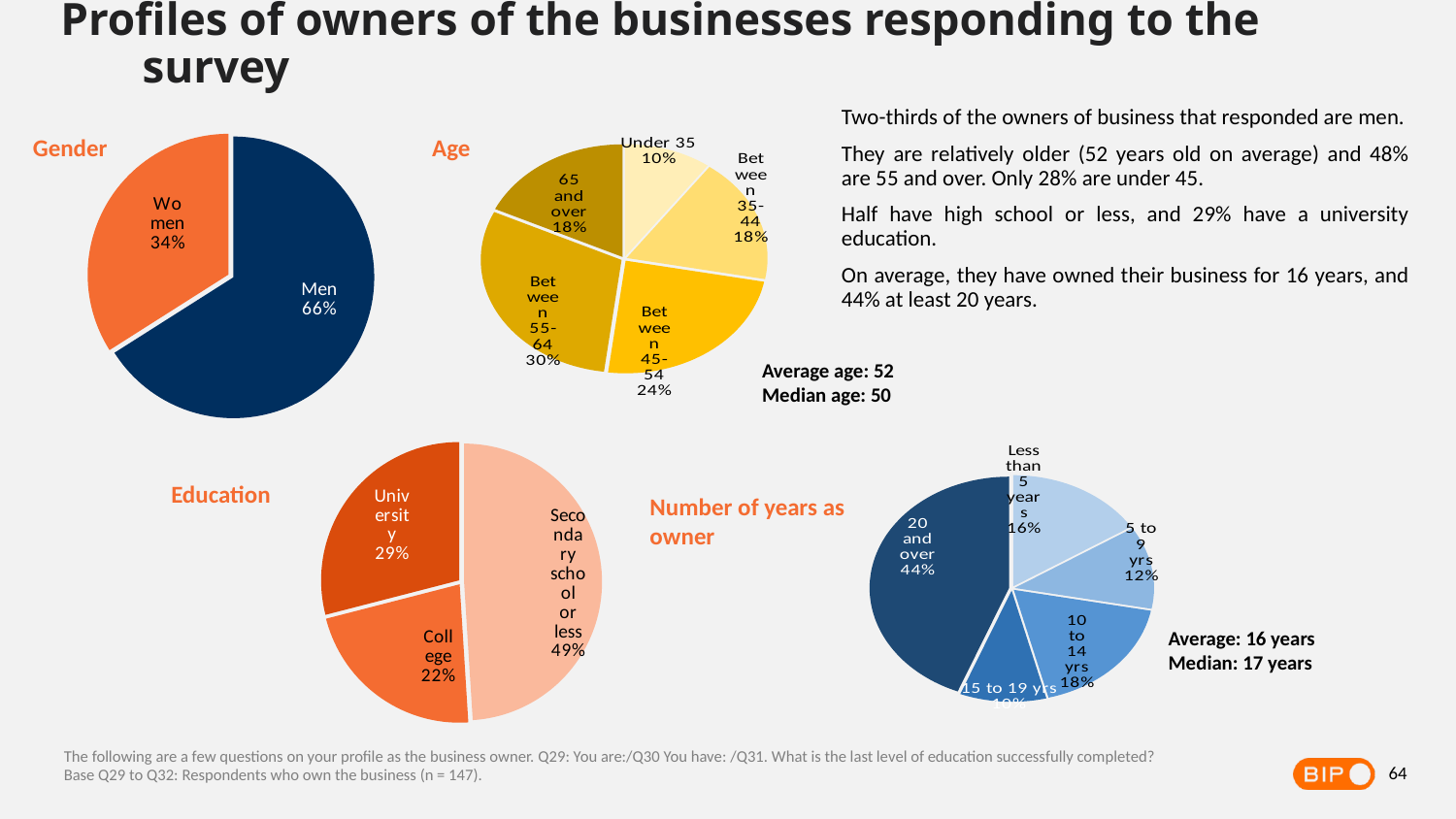
In the Number of years as owner pie chart, what share of owners have owned their business for 20 years and over? 44% In the Gender pie chart, what percentage of business owners are men? 66% In the Age pie chart, which age group has the largest share? Between 55-64 In the Age pie chart, what is the share of owners aged 45-54? 24% In the Education pie chart, which is larger: College or University? University How many age groups are shown in the Age pie chart? 5 In the Education pie chart, what share of owners have a university education? 29% In the Age pie chart, what is the difference in percentage points between the 55-64 group and the Under 35 group? 20 In the Gender pie chart, what percentage of business owners are women? 34% In the Age pie chart, which age group has the smallest share? Under 35 In the Education pie chart, which category has the largest share? Secondary school or less What type of chart is used for the Number of years as owner data? Pie chart